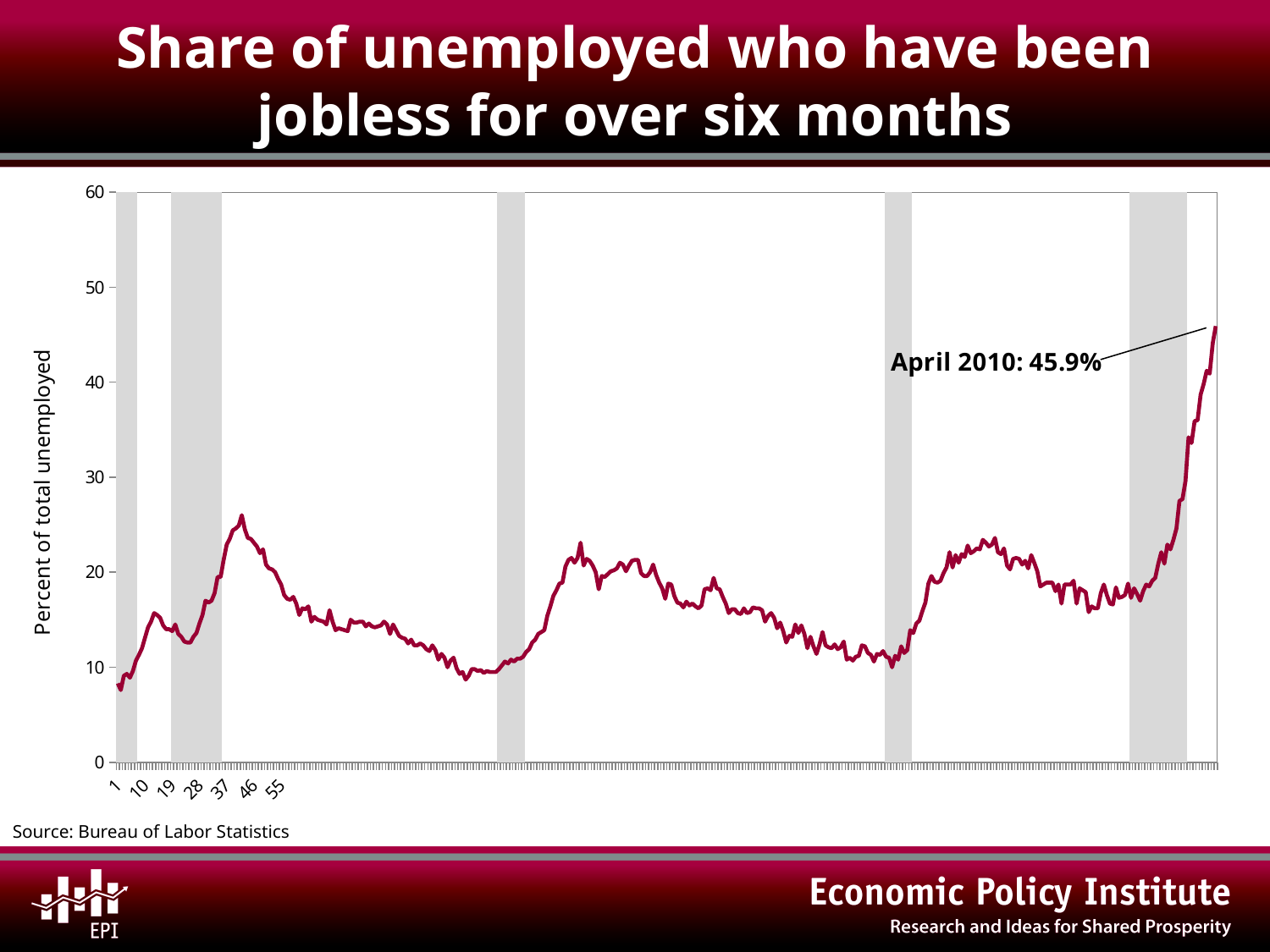
What is the title of the chart? Share of unemployed who have been jobless for over six months Is the value for April 2010 greater or less than 40? greater What is the maximum value shown on the y axis? 60 Is the value at the very start of the series greater or less than 10? less What is the label on the y axis? Percent of total unemployed What value does the chart label for April 2010? 45.9% Is the highest peak before the final rise greater or less than 30? less How many data series are plotted on the chart? 2 What kind of chart is shown on the slide? Line chart At which labelled point does the line reach its highest value? April 2010 Does the line rise or fall over the final stretch leading up to April 2010? Rises